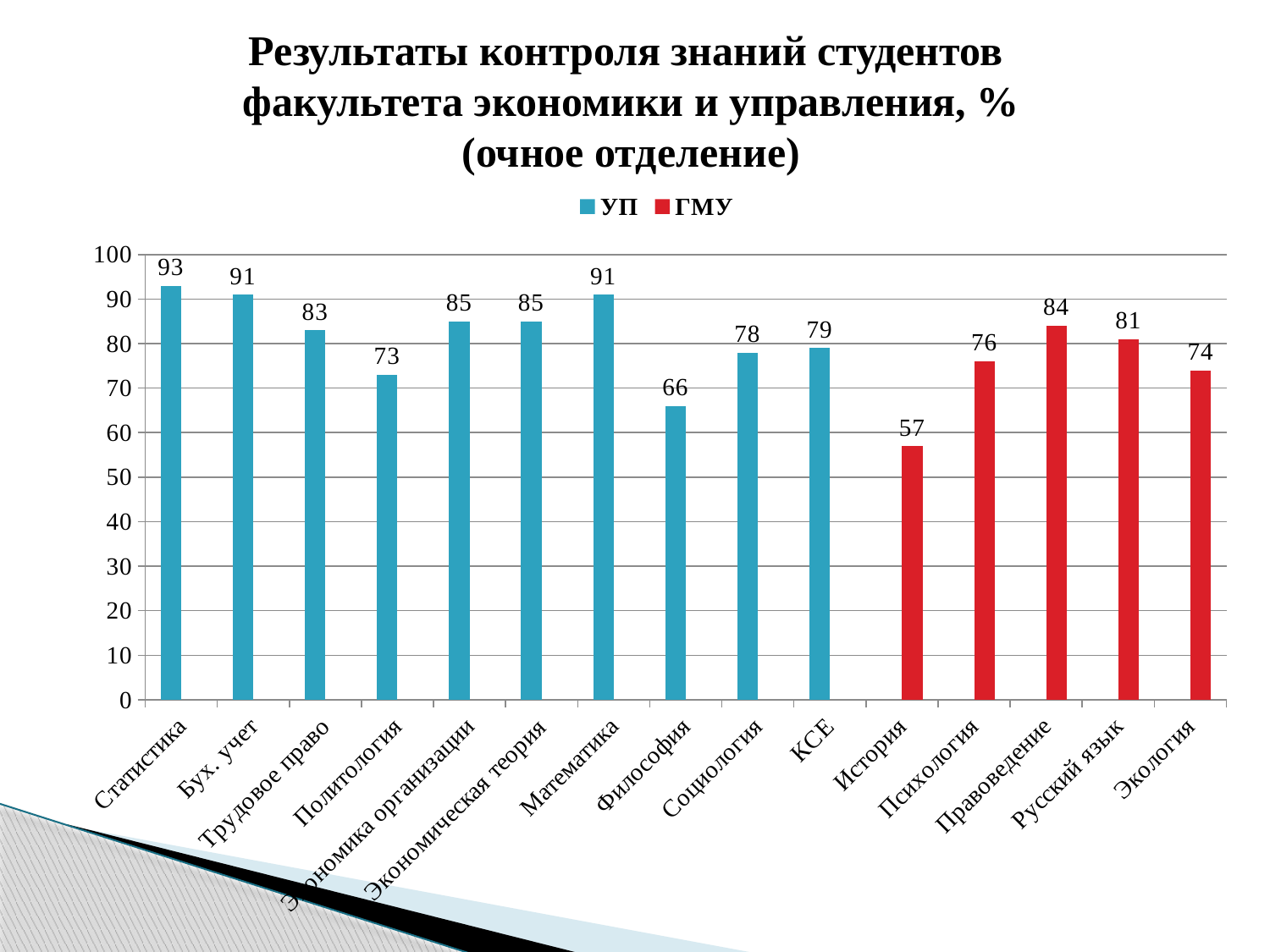
What is the difference between the values for Математика and Политология? 18 Is the value for Экология greater or less than 70? greater Which category has the highest value? Статистика What is the value for Философия? 66 What kind of chart is shown? bar chart How many categories are shown on the x axis? 15 How many series does the legend list? 2 What is the value for Статистика? 93 What is the value for Правоведение? 84 Which is larger, the value for Социология or the value for Психология? Социология Which series is shown in red? ГМУ Which category has the lowest value? История